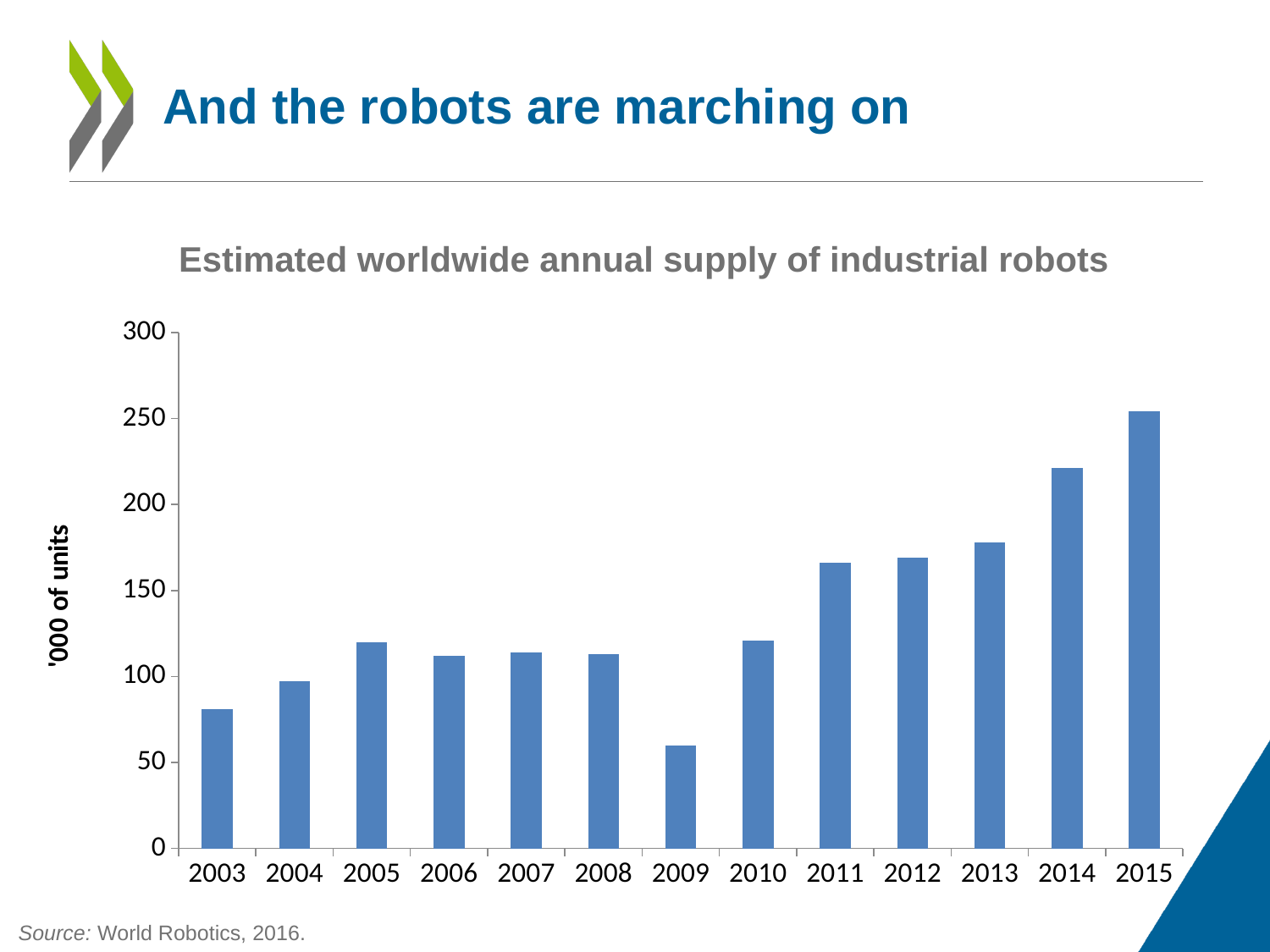
What is the label on the vertical axis of the chart? '000 of units Overall, do the values rise or fall from 2003 to 2015? rise What kind of chart is shown on the slide? bar chart Is the value for 2003 greater or less than 100? less Is the value for 2014 greater or less than 200? greater Is the value for 2009 greater or less than 100? less How many years are shown on the x axis of the chart? 13 Which year has the larger value, 2003 or 2009? 2003 Which year has the larger value, 2013 or 2014? 2014 Which year has the lowest estimated worldwide annual supply of industrial robots? 2009 Which year has the highest estimated worldwide annual supply of industrial robots? 2015